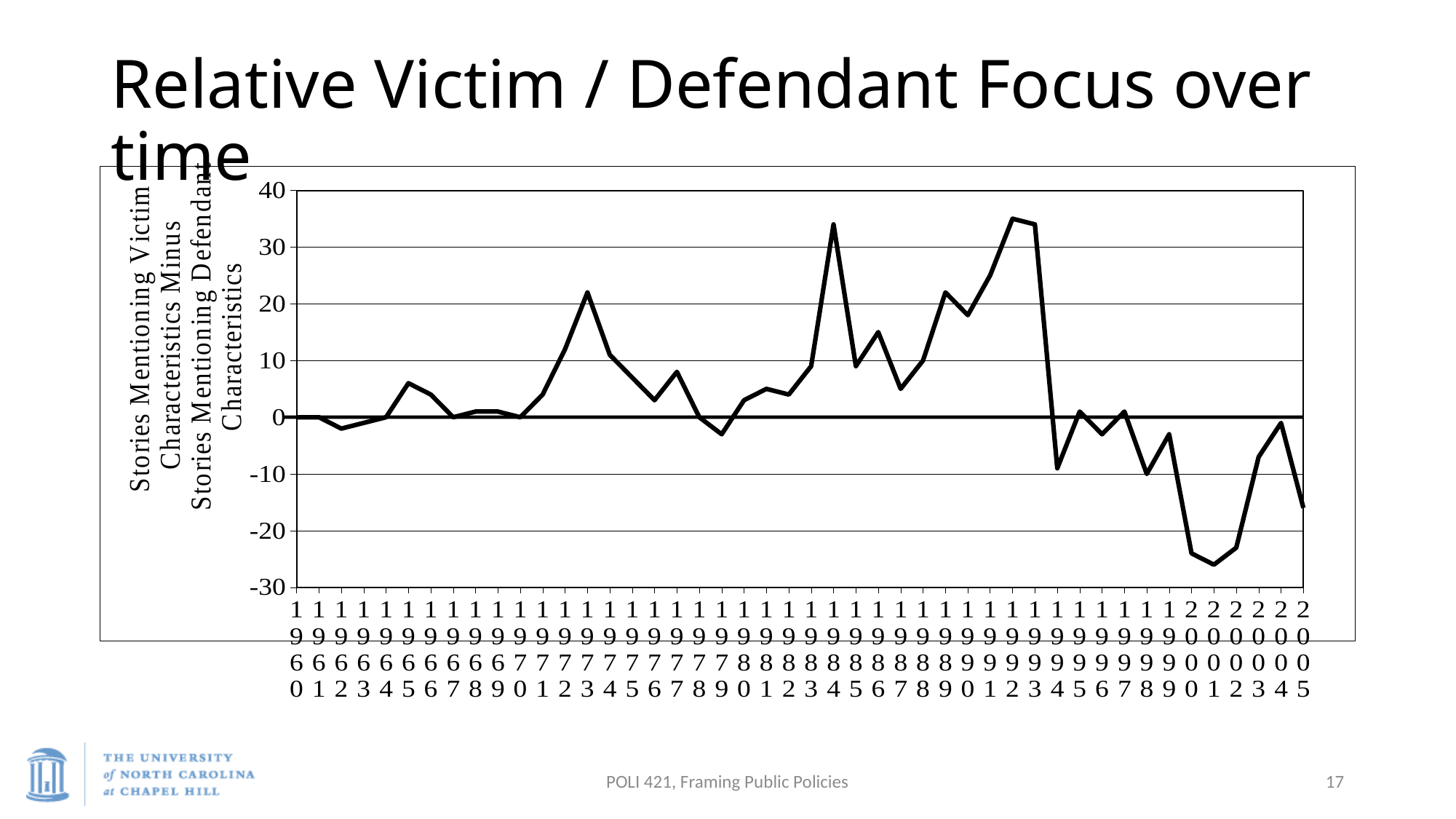
How many years are plotted along the x axis of the chart? 46 Which year has the lowest value on the chart? 2001 What kind of chart is shown on the slide? line chart What is the first year shown on the x axis of the chart? 1960 Is the value for 2001 greater or less than -20? less Is the value for 1973 greater or less than 20? greater What is the last year shown on the x axis of the chart? 2005 Is the value for 1984 greater or less than 30? greater Which year has the larger value, 1973 or 1986? 1973 Do the values rise or fall from 1998 to 2001? fall